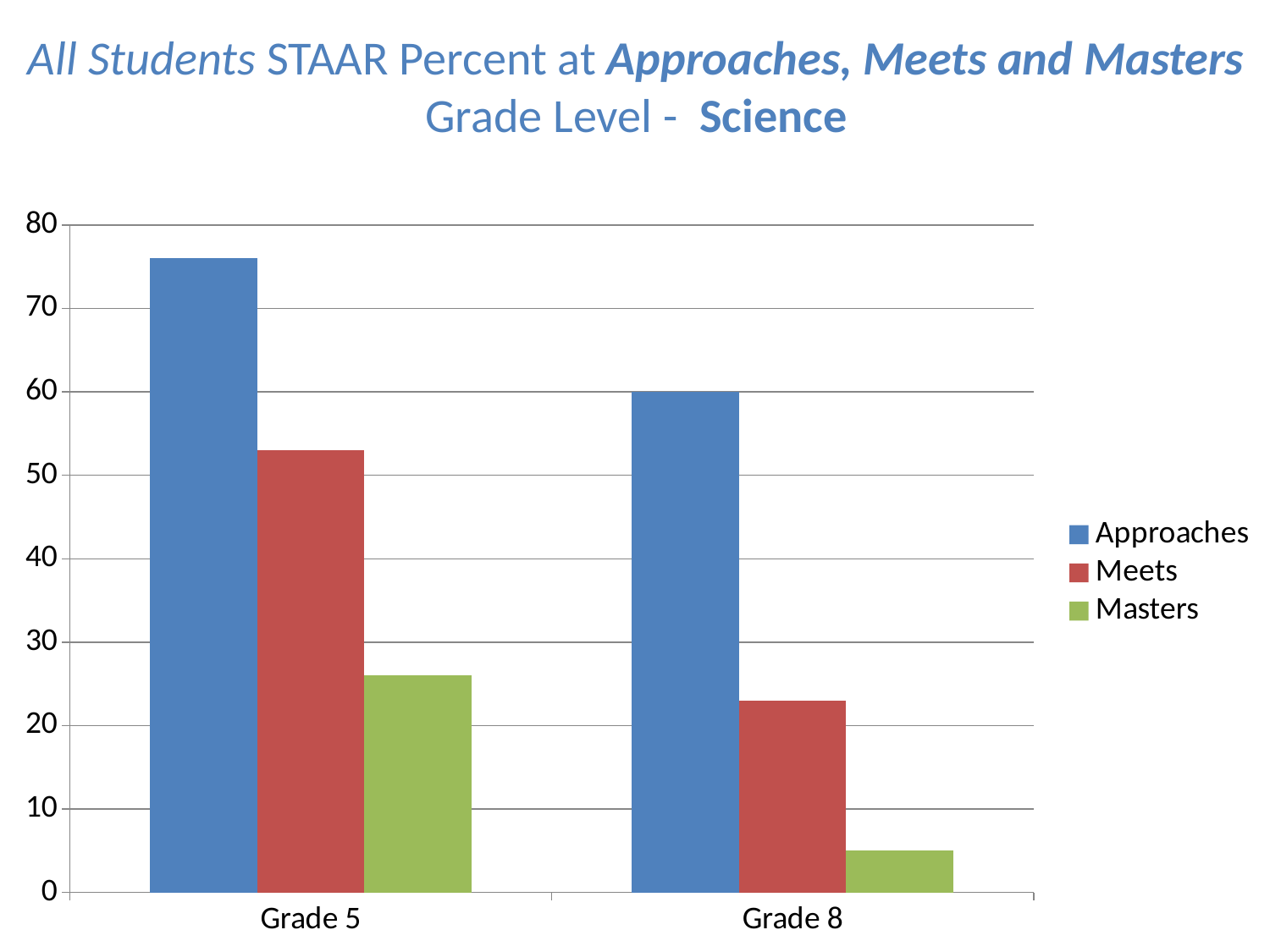
How many grade levels are shown on the x axis? 2 Do the Approaches values rise or fall from Grade 5 to Grade 8? fall Which subject does the chart title say the STAAR percentages are for? Science Which series has the lowest bar for Grade 8? Masters What kind of chart is shown on the slide? bar chart Which grade level has the highest Approaches bar? Grade 5 How many series does the legend list? 3 Is the Meets value for Grade 5 greater or less than 50? greater Which is larger, the Masters value for Grade 5 or the Meets value for Grade 8? Masters value for Grade 5 Is the Approaches value for Grade 5 greater or less than 70? greater Is the Masters value for Grade 8 greater or less than 10? less